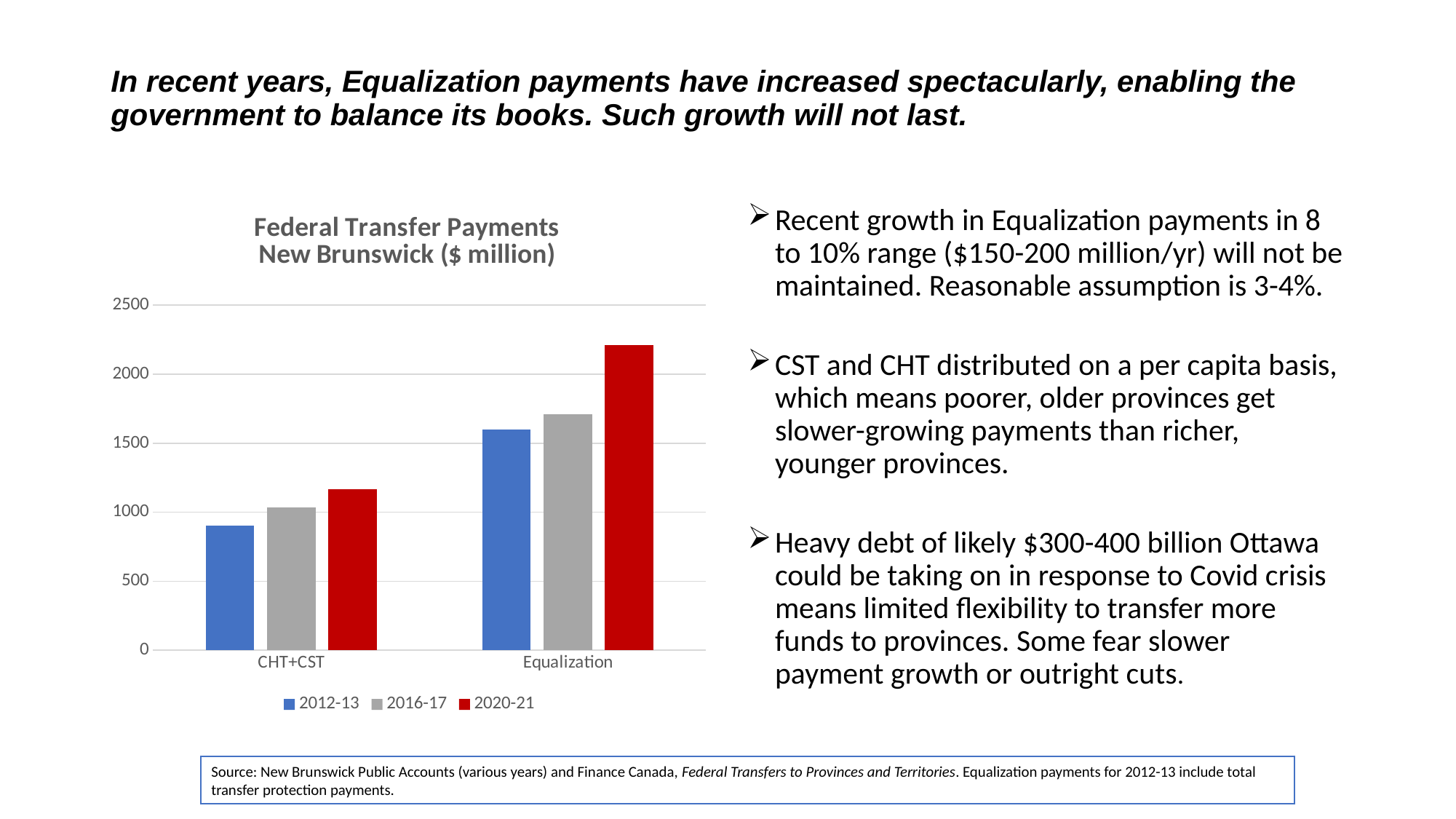
Is the 2012-13 value for CHT+CST greater or less than 1000? less Is the 2020-21 value for Equalization greater or less than 2000? greater Which category and year has the lowest bar in the Federal Transfer Payments chart? CHT+CST, 2012-13 Is the 2012-13 value for Equalization greater or less than 1500? greater What kind of chart is shown on the slide? bar chart Which category and year has the highest bar in the Federal Transfer Payments chart? Equalization, 2020-21 How many series does the legend of the Federal Transfer Payments chart list? 3 Which colour represents the 2020-21 series in the Federal Transfer Payments chart? red How many categories are shown on the x axis of the Federal Transfer Payments chart? 2 For 2020-21, which is larger: CHT+CST or Equalization? Equalization Do the Equalization payments rise or fall from 2012-13 to 2020-21? rise